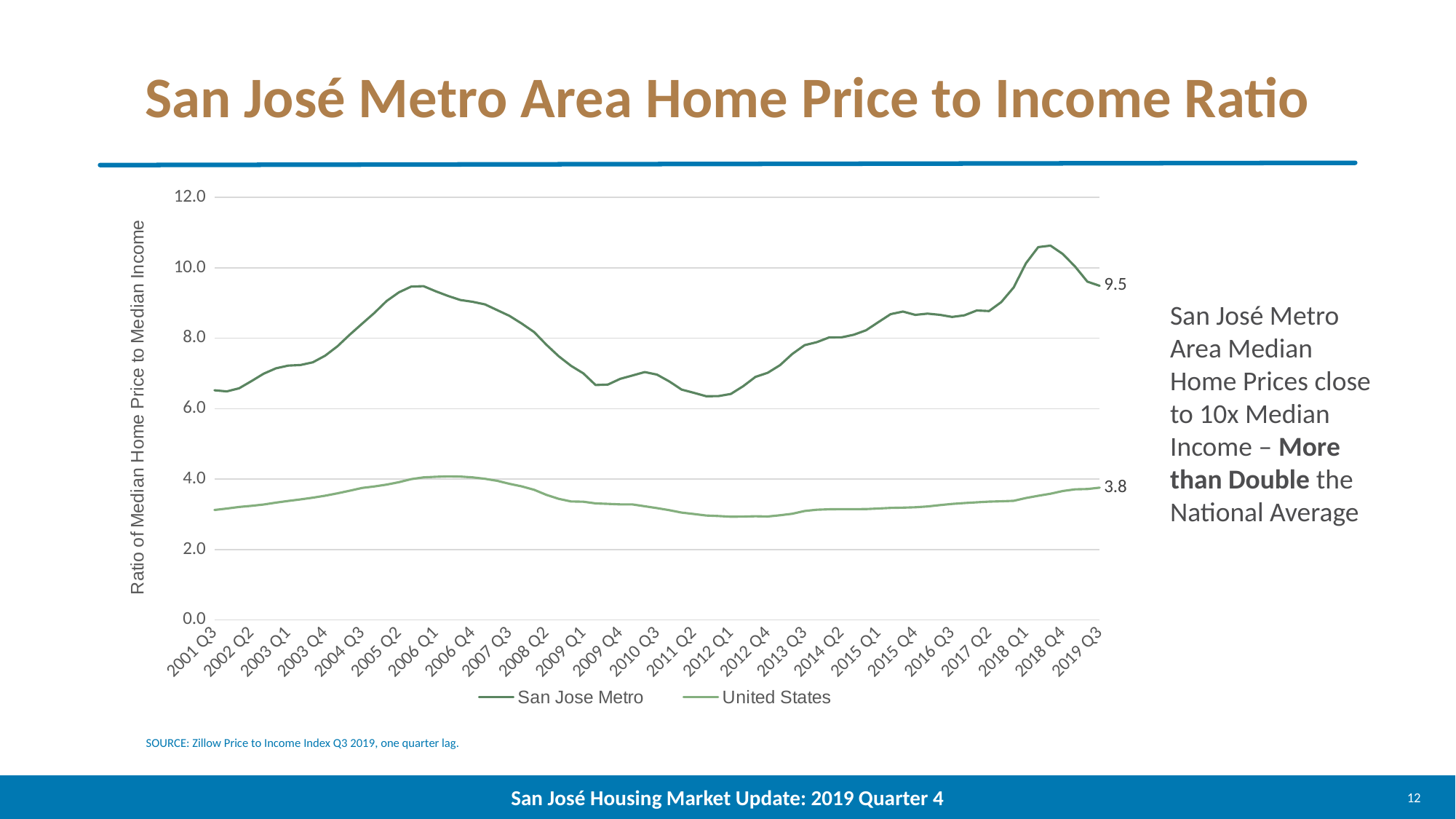
Is the United States value at 2001 Q3 greater or less than 4.0? less What is the United States home price to income ratio at 2019 Q3? 3.8 What kind of chart is shown on the slide? line chart Does the San Jose Metro line rise or fall between 2012 Q1 and 2018 Q4? rise Is the San Jose Metro value at 2018 Q4 greater or less than 10.0? greater What is the San Jose Metro home price to income ratio at 2019 Q3? 9.5 Is the San Jose Metro value at 2012 Q1 greater or less than 8.0? less What are the two series named in the legend? San Jose Metro and United States How many series does the legend list? 2 Which series has the higher value at 2019 Q3, San Jose Metro or United States? San Jose Metro What is the difference between the San Jose Metro and United States ratios at 2019 Q3? 5.7 What is the title of the vertical axis? Ratio of Median Home Price to Median Income